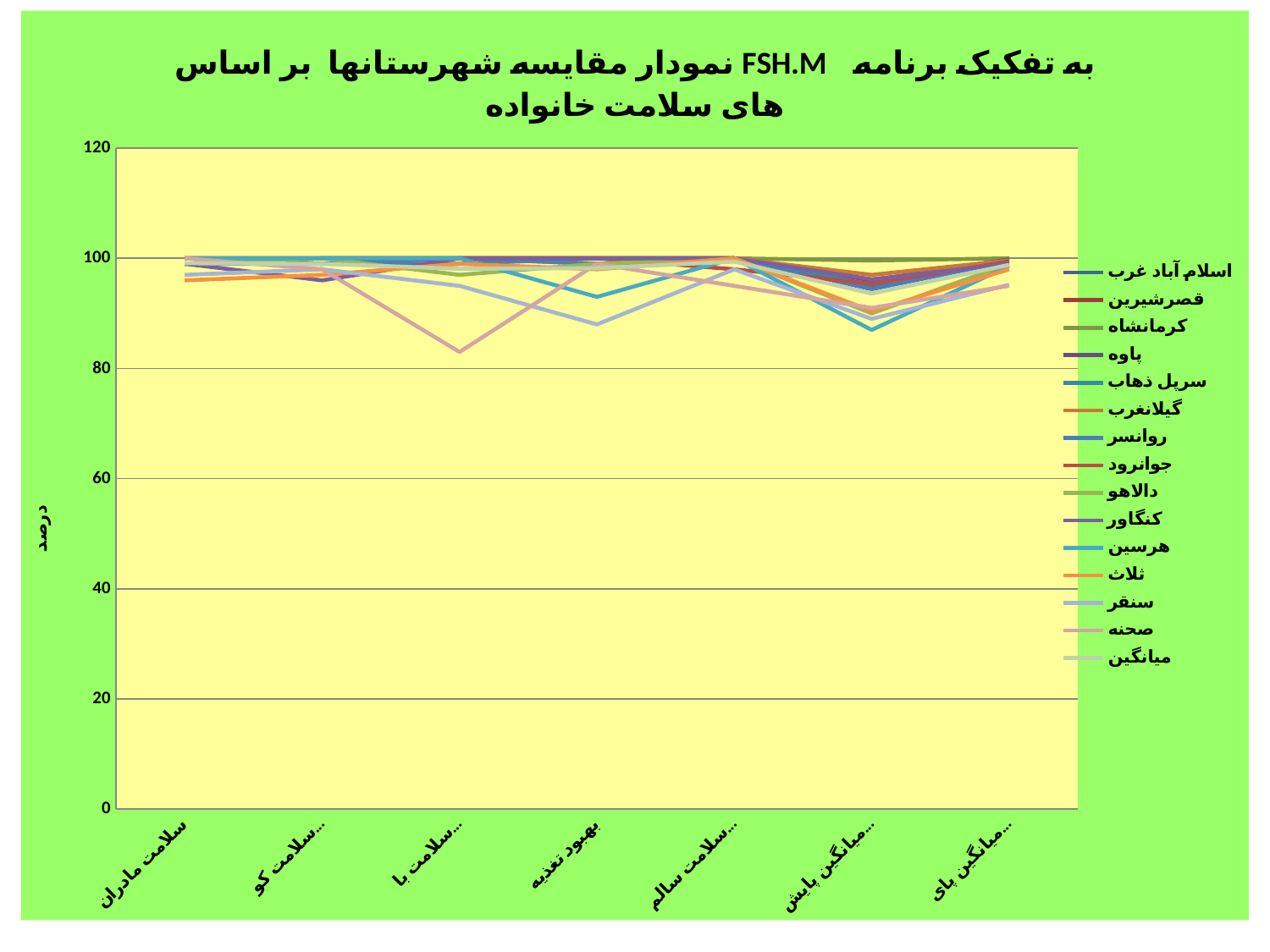
How many categories are shown along the x axis? 7 Is the value for هرسین at the category میانگین پایش greater or less than 100? less Is the value for سرپل ذهاب at the category بهبود تغذیه greater or less than 80? greater How many series does the legend list? 15 What is the highest value shown on the vertical axis? 120 Are any of the plotted values below 60? No Which series is listed last in the legend? میانگین What kind of chart is shown on the slide? line chart What is the label on the vertical axis? درصد